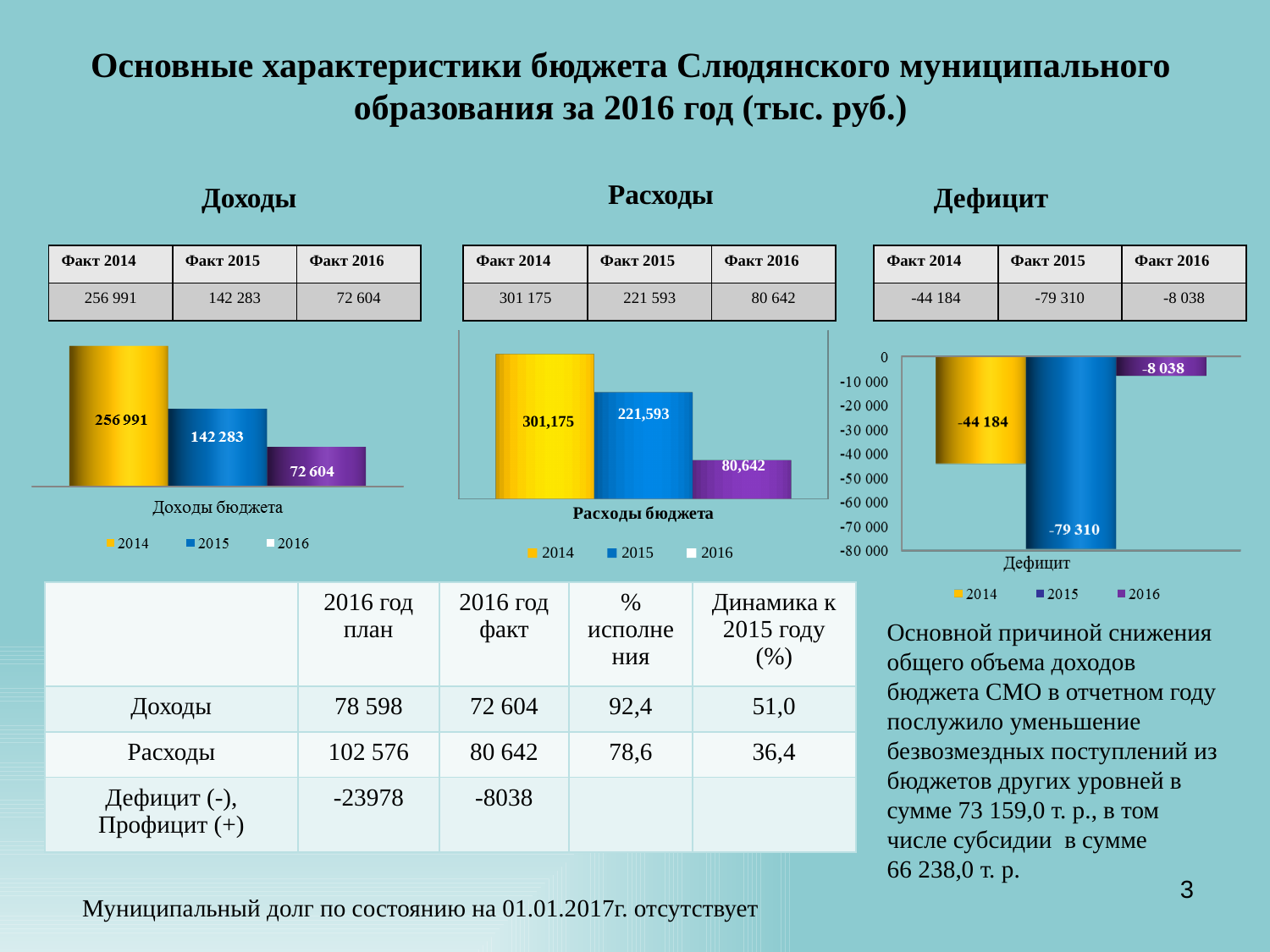
In the Расходы chart, which is larger, the value for 2015 or the value for 2016? 2015 In the Доходы chart, what is the value for 2016? 72 604 In the Доходы chart, which year has the highest value? 2014 In the Доходы chart, do the values rise or fall from 2014 to 2016? fall In the Доходы chart, what is the difference between the 2014 and 2015 values? 114 708 In the Дефицит chart, what is the value for 2015? -79 310 In the Расходы chart, what is the value for 2015? 221,593 In the Расходы chart, what is the difference between the 2014 and 2016 values? 220,533 How many series does the legend of the Дефицит chart list? 3 In the Дефицит chart, which year has the lowest (most negative) value? 2015 In the Доходы chart, what is the value for 2014? 256 991 What kind of chart is the Расходы chart? bar chart